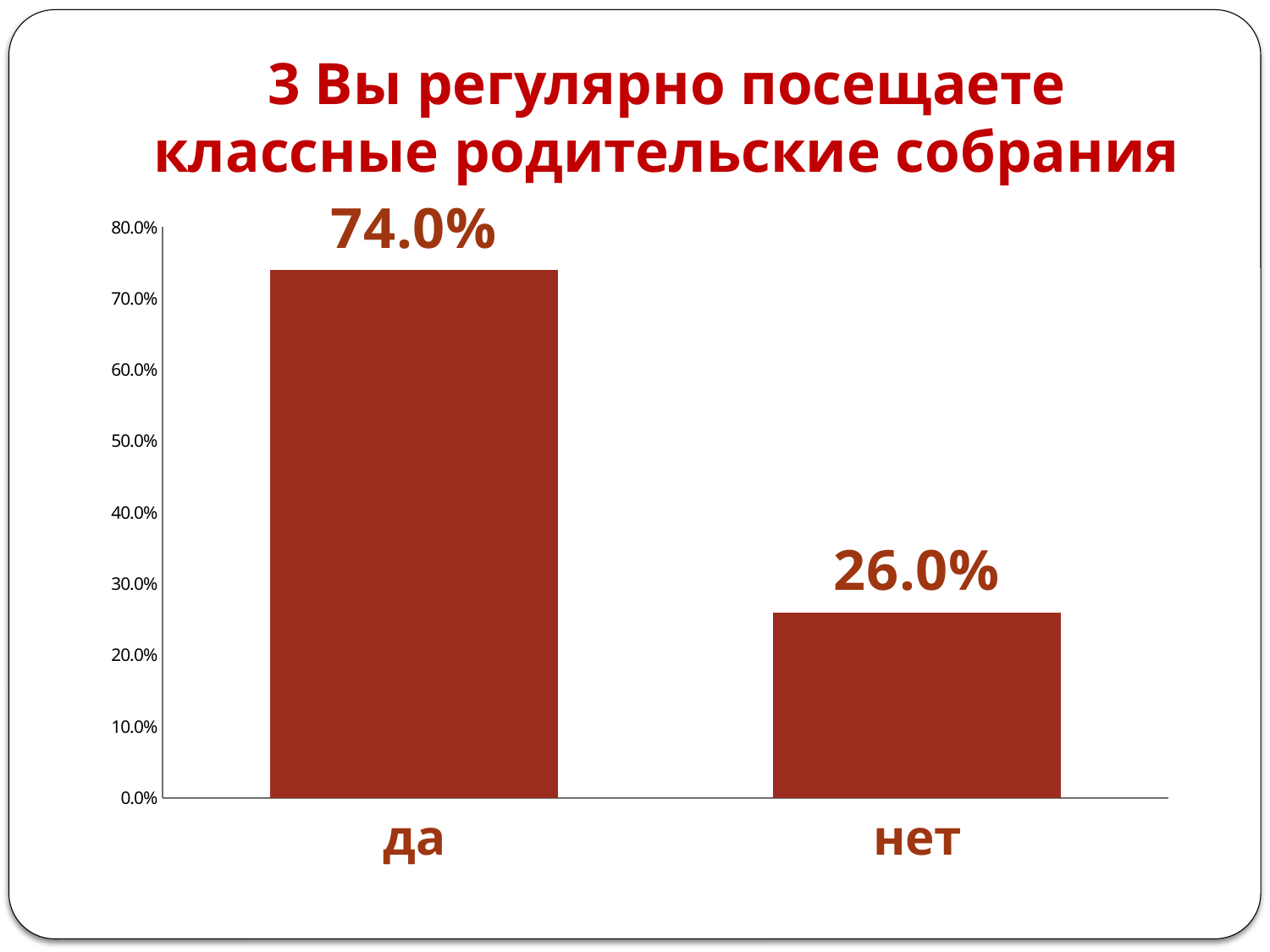
Is the value for "нет" greater or less than 30.0%? less Which is larger, the value for "да" or the value for "нет"? да Which category has the lowest value? нет What kind of chart is shown on the slide? bar chart What is the highest value shown on the vertical axis? 80.0% What is the title of the chart? 3 Вы регулярно посещаете классные родительские собрания Is the value for "да" greater or less than 70.0%? greater What is the difference between the values for "да" and "нет"? 48.0% What is the value for "да"? 74.0% What is the value for "нет"? 26.0% Which category has the highest value? да How many categories are shown on the chart? 2